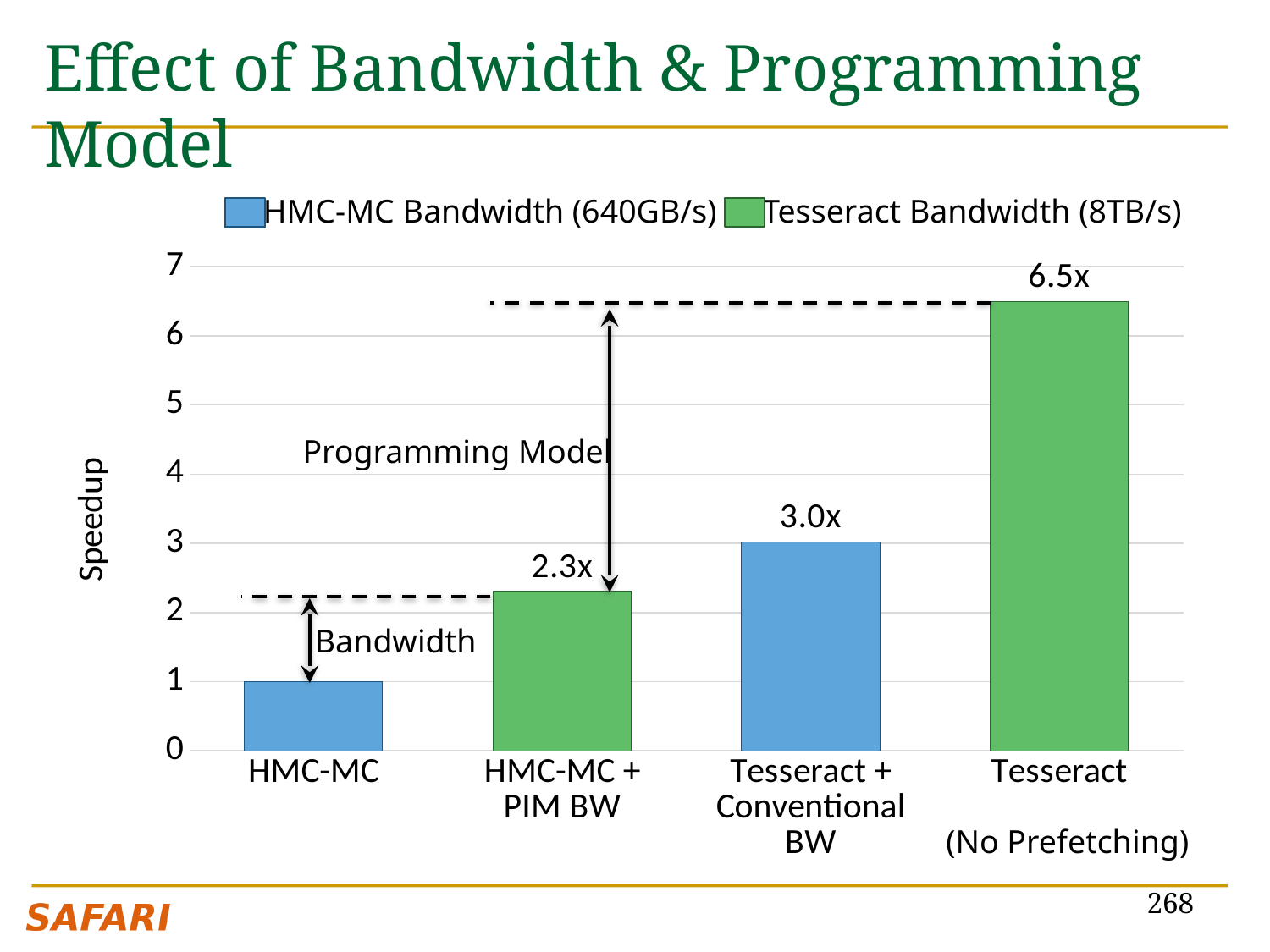
How many series does the legend list? 2 Which category has the lowest speedup? HMC-MC What is the speedup value shown for Tesseract (No Prefetching)? 6.5x Which category has the highest speedup? Tesseract (No Prefetching) What is the speedup value shown for HMC-MC + PIM BW? 2.3x What is the speedup value shown for Tesseract + Conventional BW? 3.0x Which has a larger speedup, Tesseract + Conventional BW or HMC-MC + PIM BW? Tesseract + Conventional BW What is the label of the y axis of the chart? Speedup Is the speedup value for HMC-MC greater or less than 2? less What is the difference in speedup between Tesseract (No Prefetching) and HMC-MC + PIM BW? 4.2x How many categories are shown on the x axis of the chart? 4 What kind of chart is shown on the slide? bar chart